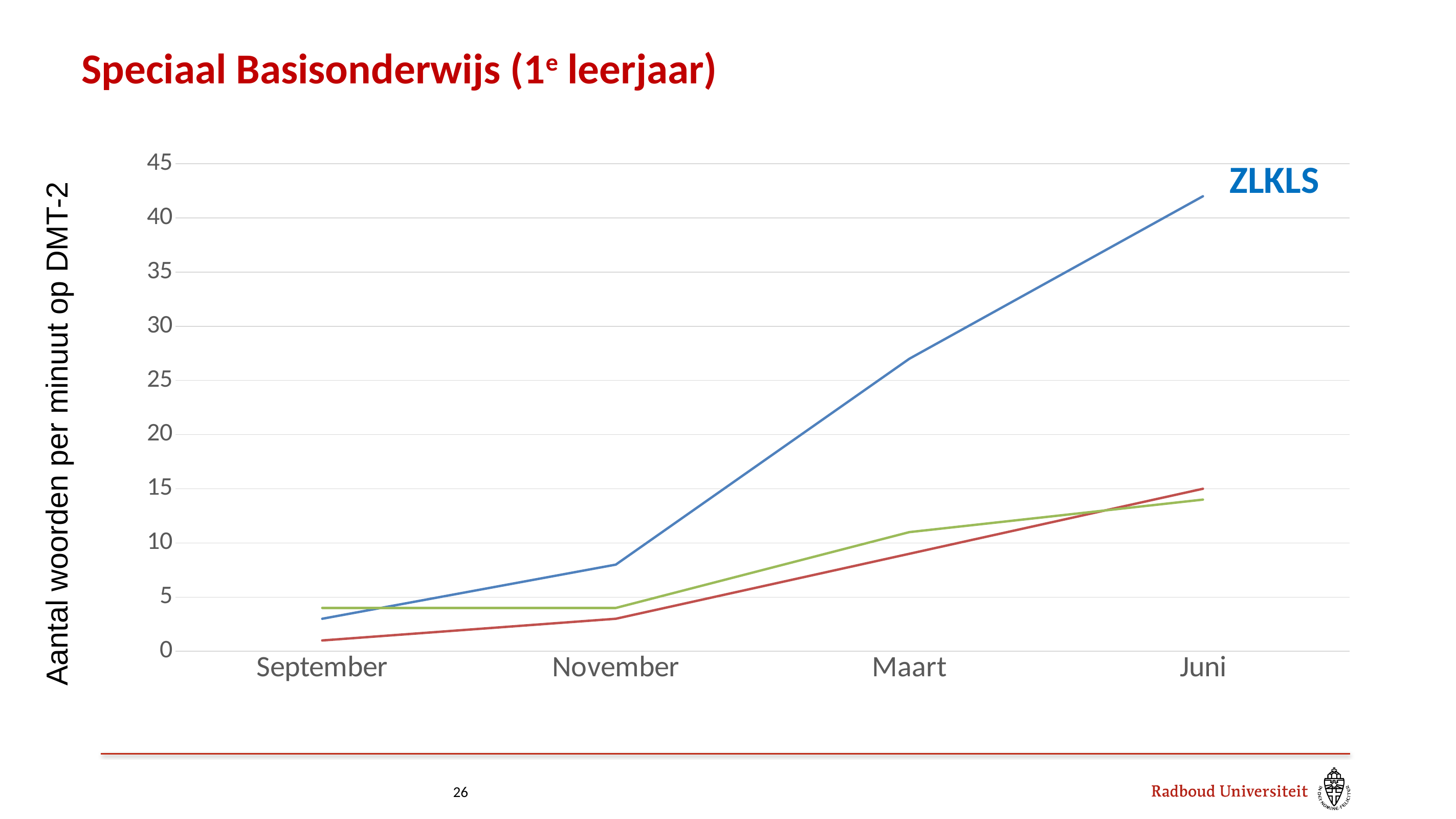
Is the value of the red line in September greater or less than 5? less In which month does the ZLKLS line reach its highest value? Juni Is the value of the ZLKLS line in November greater or less than 10? less In which month does the ZLKLS line have its lowest value? September In Juni, which line is higher: the ZLKLS line or the red line? ZLKLS How many time points are shown along the x axis? 4 How many lines are plotted in the chart? 3 What kind of chart is shown on the slide? line chart Is the value of the ZLKLS line in Juni greater or less than 40? greater What is the label on the y axis of the chart? Aantal woorden per minuut op DMT-2 Does the ZLKLS line rise or fall from September to Juni? rise